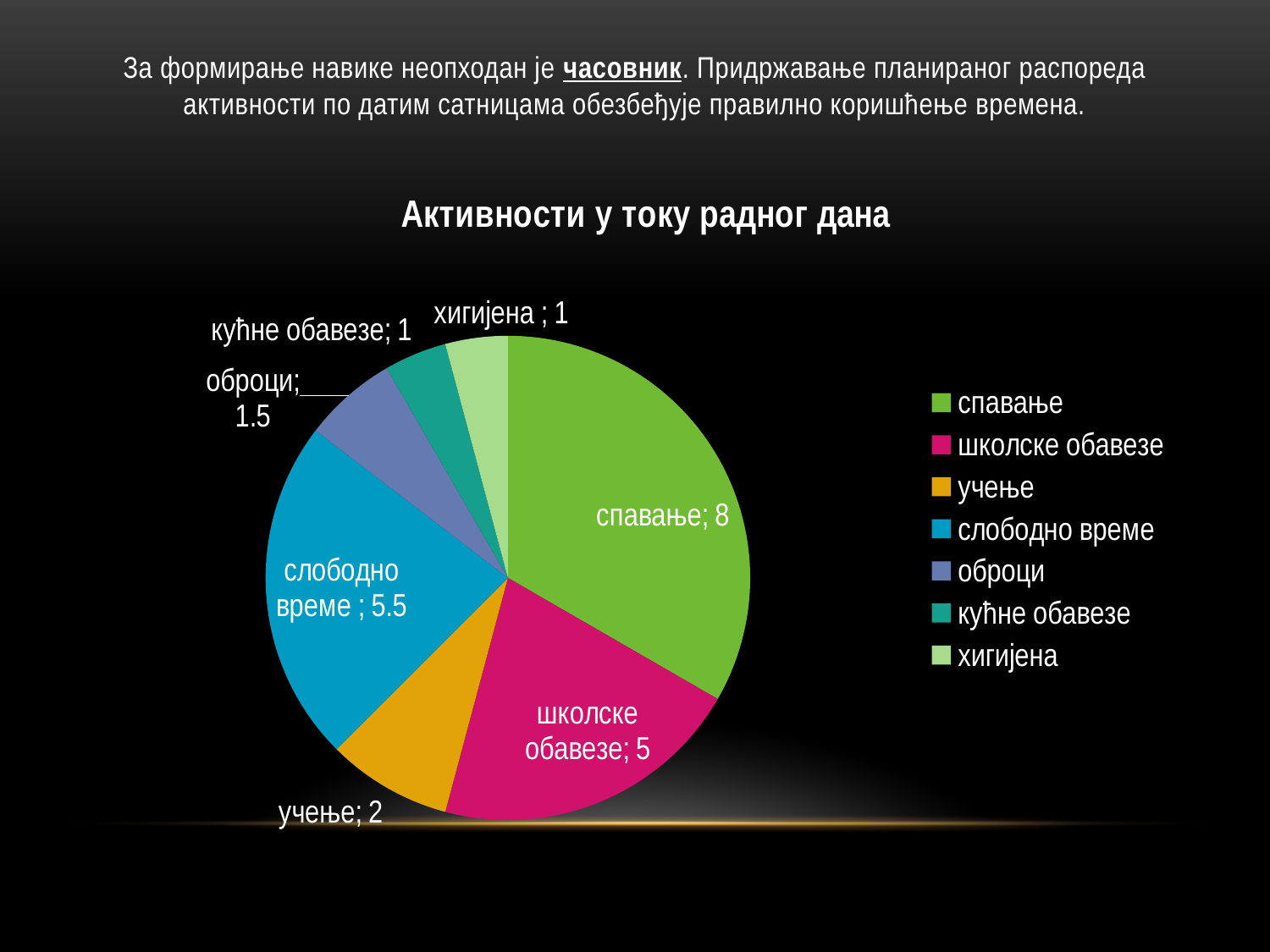
What type of chart is shown on the slide? pie chart How many categories does the pie chart have? 7 What is the title of the chart? Активности у току радног дана What is the value for учење? 2 What share of the total does спавање represent? 1/3 What is the total of all the slices in the pie chart? 24 What is the value for слободно време? 5.5 Which category has the largest slice of the pie? спавање What is the difference between the values for спавање and школске обавезе? 3 What is the value for оброци? 1.5 What is the value for спавање? 8 Which is larger, the value for школске обавезе or the value for слободно време? слободно време